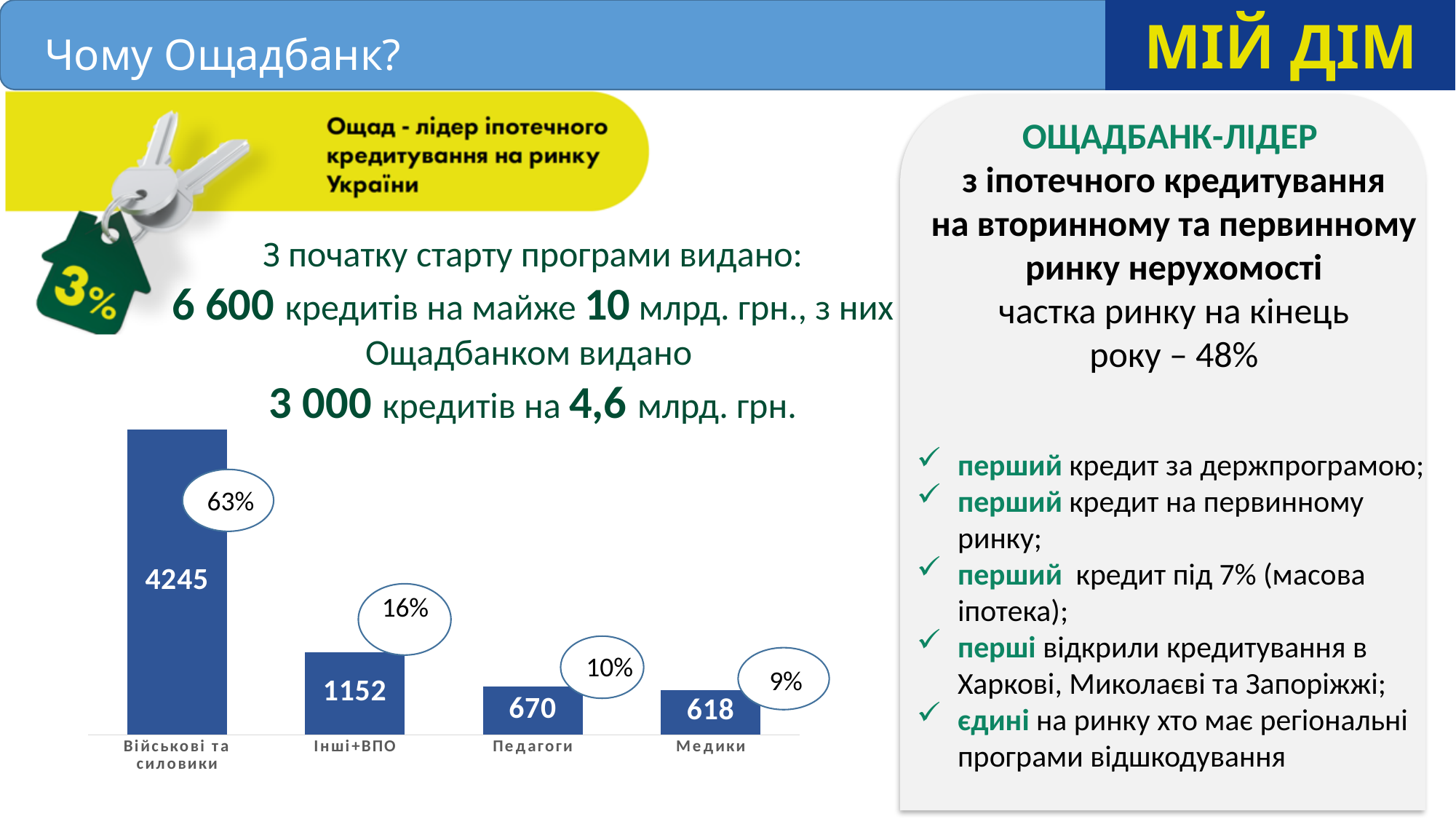
What is the value for Інші+ВПО? 1152 Which category has the lowest value? Медики How many categories are shown in the chart? 4 What kind of chart is shown on the slide? Bar chart Which is larger, the value for Педагоги or the value for Медики? Педагоги What percentage is shown for Медики? 9% What is the value for Педагоги? 670 What is the difference between the values for Військові та силовики and Інші+ВПО? 3093 Which category has the highest value? Військові та силовики What percentage is shown for Інші+ВПО? 16% What is the value for Медики? 618 What is the value for Військові та силовики? 4245